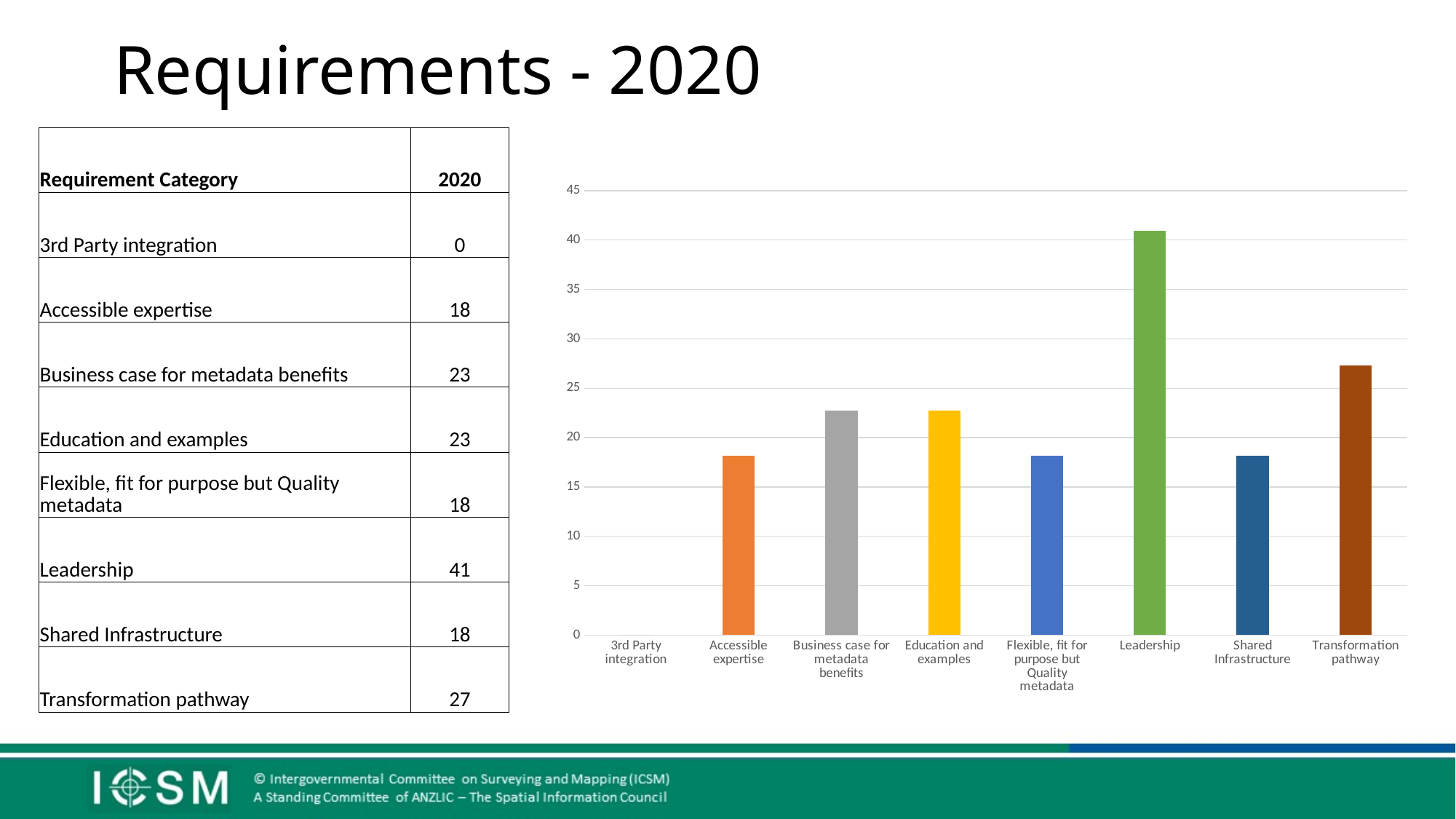
Which is larger, the value for Education and examples or the value for Shared Infrastructure? Education and examples What is the highest value shown on the chart's vertical axis? 45 What is the 2020 value for Transformation pathway? 27 How many requirement categories are shown on the x axis of the chart? 8 What is the difference between the values for Leadership and Transformation pathway? 14 Which requirement category has the highest value in the chart? Leadership Is the value for Accessible expertise greater or less than 20? less What is the 2020 value for Leadership? 41 Which requirement category has the lowest value in the chart? 3rd Party integration What is the 2020 value for Business case for metadata benefits? 23 Is the value for Leadership greater or less than 40? greater What type of chart is shown on the slide? bar chart